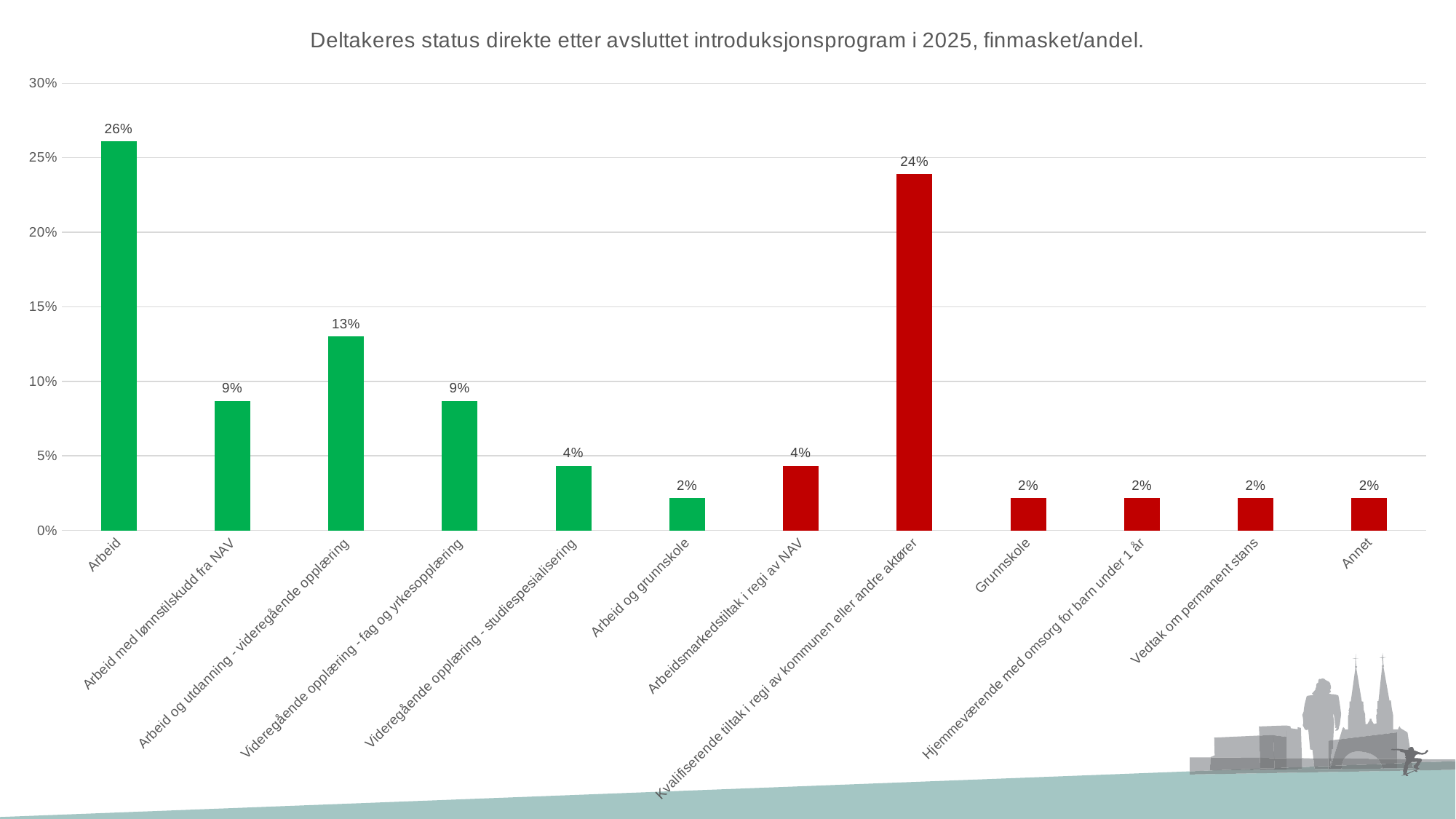
What colour is the bar for Grunnskole? Red Is the value for Arbeid greater or less than 25%? greater What is the value for Vedtak om permanent stans? 2% How many categories are shown on the x axis? 12 Which category has the highest value? Arbeid What is the value for Arbeid? 26% What is the difference between the values for Arbeid and Kvalifiserende tiltak i regi av kommunen eller andre aktører? 2 percentage points What is the value for Arbeid og utdanning - videregående opplæring? 13% What is the value for Arbeidsmarkedstiltak i regi av NAV? 4% What is the value for Kvalifiserende tiltak i regi av kommunen eller andre aktører? 24% Which is larger, the value for Arbeid med lønnstilskudd fra NAV or the value for Arbeid og utdanning - videregående opplæring? Arbeid og utdanning - videregående opplæring What kind of chart is shown on the slide? Bar chart